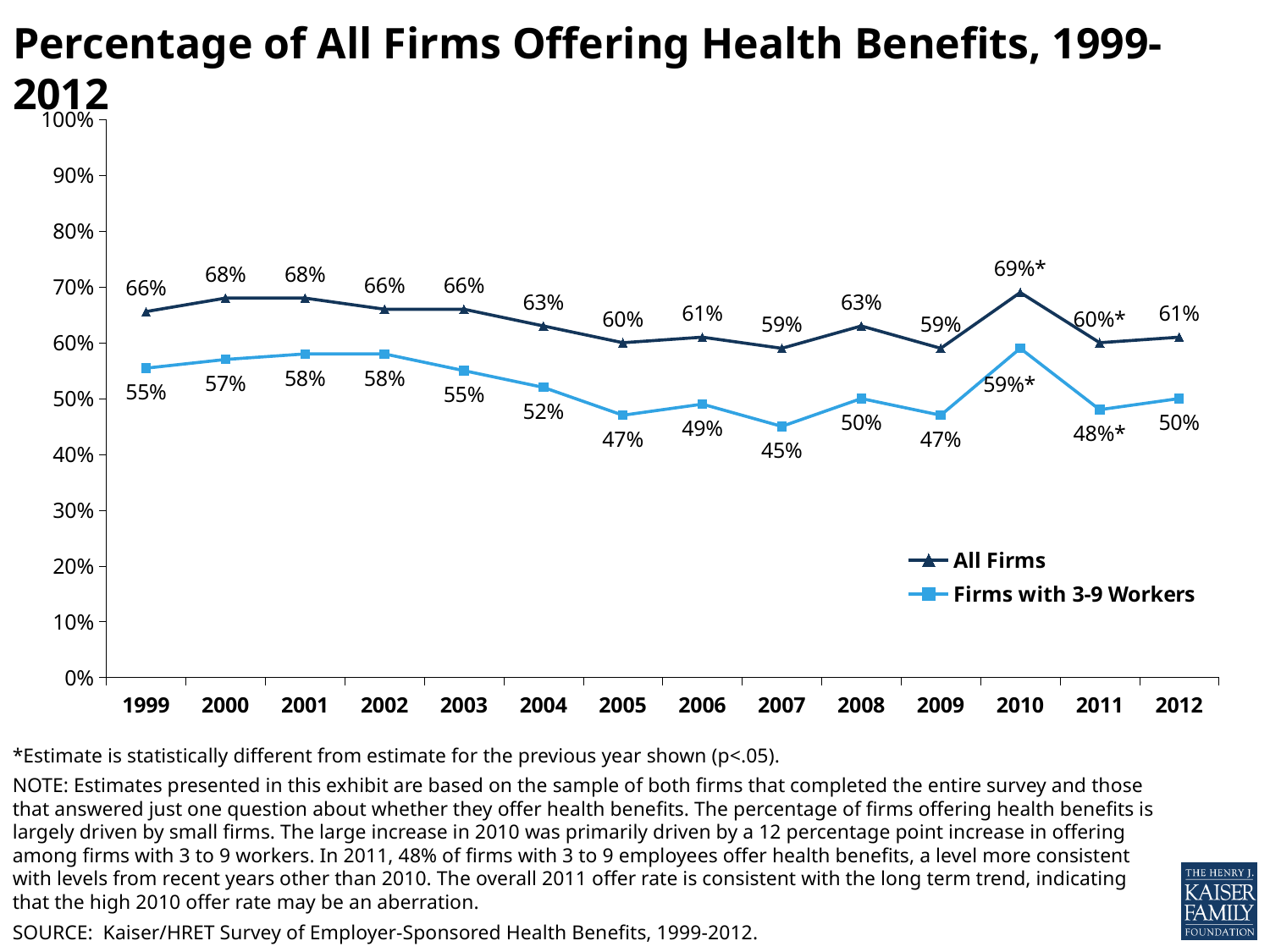
What kind of chart is shown on the slide? Line chart In which year is the All Firms series at its highest? 2010 Which series has the higher value in 2007, All Firms or Firms with 3-9 Workers? All Firms What percentage of Firms with 3-9 Workers offered health benefits in 2004? 52% What is the value for All Firms in 2010? 69%* How many series does the legend list? 2 What percentage of All Firms offered health benefits in 2005? 60% In which year is the Firms with 3-9 Workers series at its lowest? 2007 What is the difference in percentage points between All Firms and Firms with 3-9 Workers in 2010? 10 percentage points What is the difference in percentage points between the Firms with 3-9 Workers values for 2010 and 2011? 11 percentage points Does the Firms with 3-9 Workers series rise or fall from 2010 to 2011? Fall How many years are shown on the x axis? 14